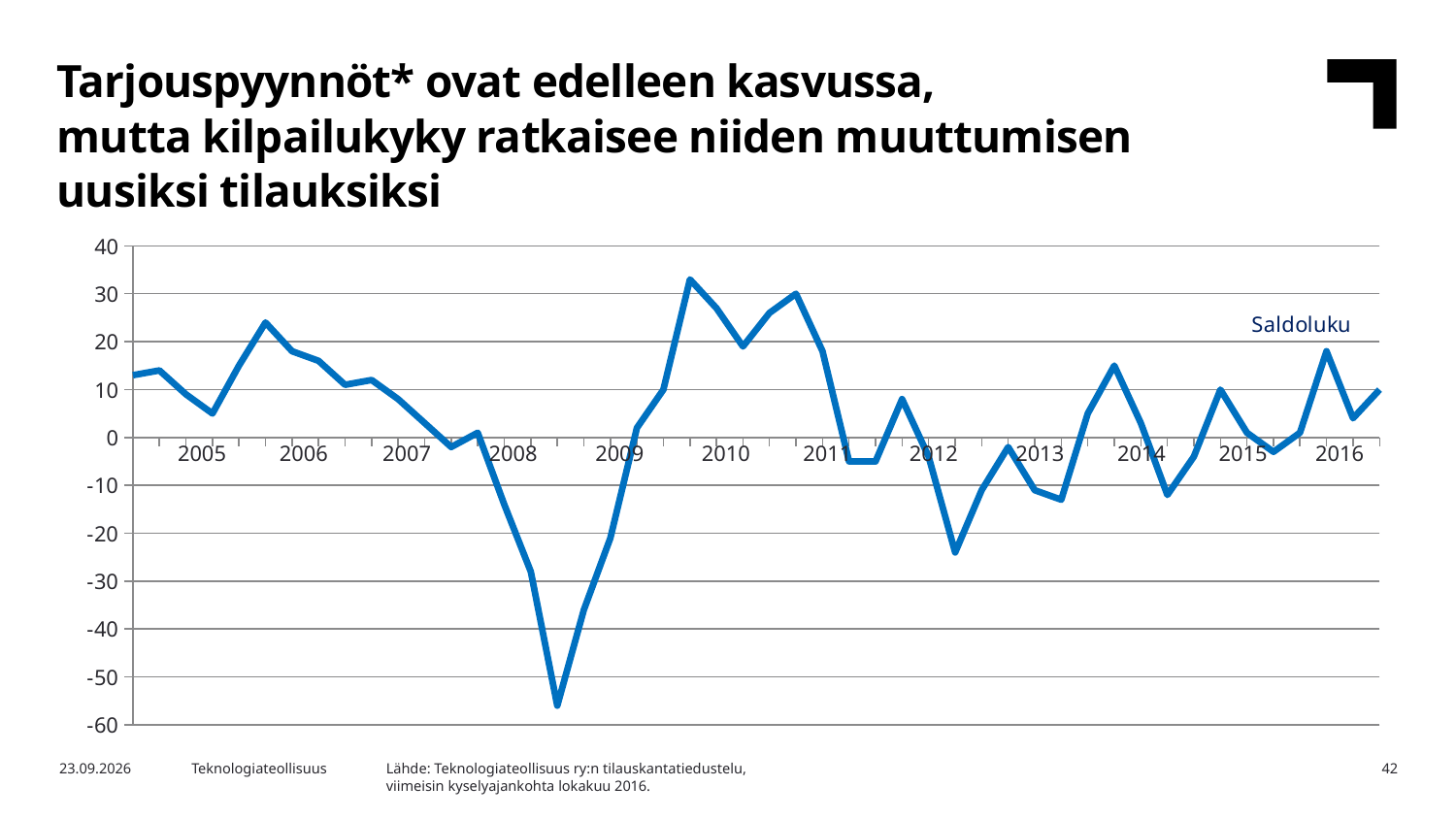
What are the minimum and maximum values shown on the y axis? -60 and 40 What is the name of the series shown on the chart? Saldoluku Is the peak value reached in 2016 greater or less than 10? greater Is the lowest value reached in 2012 greater or less than -20? less Is the lowest point of the line, in 2008, greater or less than -50? less How many years are labelled on the x axis? 12 Does the line rise or fall from its 2008 trough to its peak in 2009? rise How many series does the chart plot? 1 What kind of chart is shown on the slide? line chart In which year does the line reach its lowest value? 2009